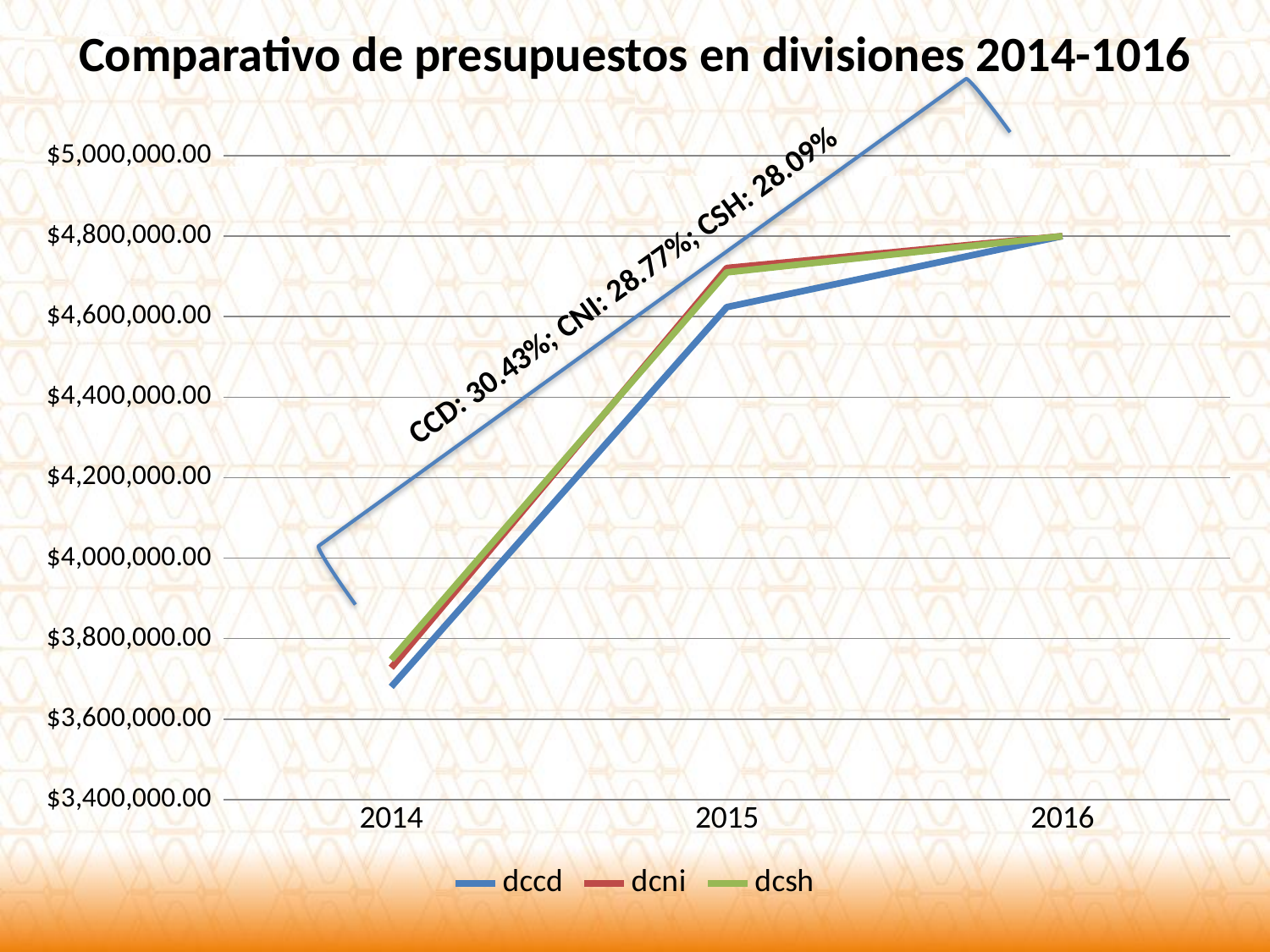
Is the value for dccd in 2014 greater or less than $3,800,000.00? less How many years are shown on the x axis? 3 Which series has the lowest value in 2015? dccd How many series does the legend list? 3 What is the title of the chart? Comparativo de presupuestos en divisiones 2014-1016 Is the value for dcni in 2015 greater or less than $4,600,000.00? greater In 2014, which is larger, the value for dccd or the value for dcsh? dcsh Which series are listed in the legend? dccd, dcni, dcsh Is the value for dccd in 2015 greater or less than $4,400,000.00? greater What kind of chart is shown on the slide? line chart Do the values for dccd rise or fall from 2014 to 2016? rise